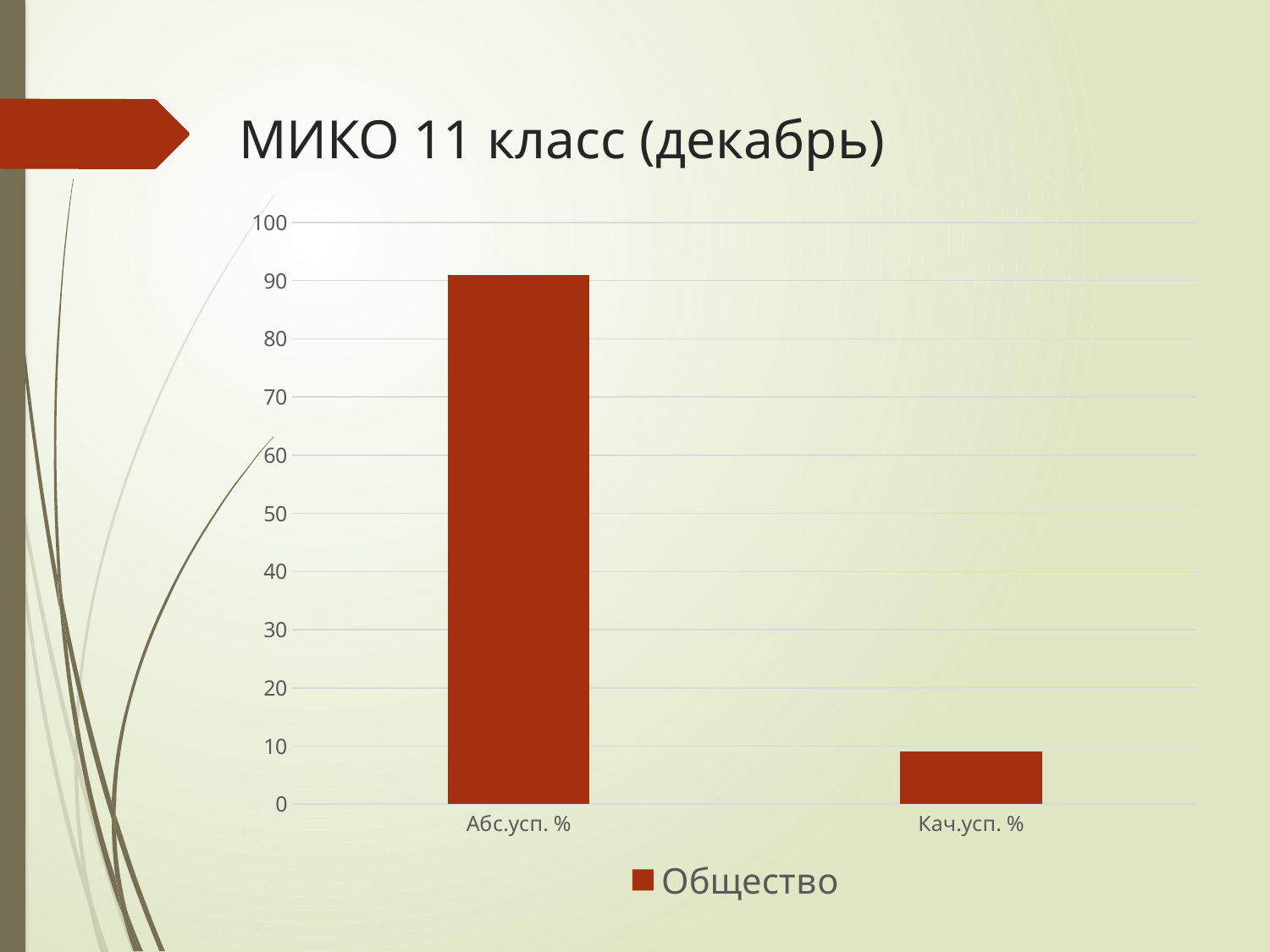
How many series does the legend list? 1 Do the values rise or fall from Абс.усп. % to Кач.усп. % along the x axis? fall What kind of chart is shown on the slide? bar chart Which is larger, the value for Абс.усп. % or the value for Кач.усп. %? Абс.усп. % Which category has the highest value? Абс.усп. % Is the value for Кач.усп. % greater or less than 20? less Is the value for Абс.усп. % greater or less than 80? greater Is the value for Абс.усп. % greater or less than 100? less How many categories are shown on the x axis? 2 What series name is shown in the legend? Общество Which category has the lowest value? Кач.усп. % What is the title of the slide? МИКО 11 класс (декабрь)